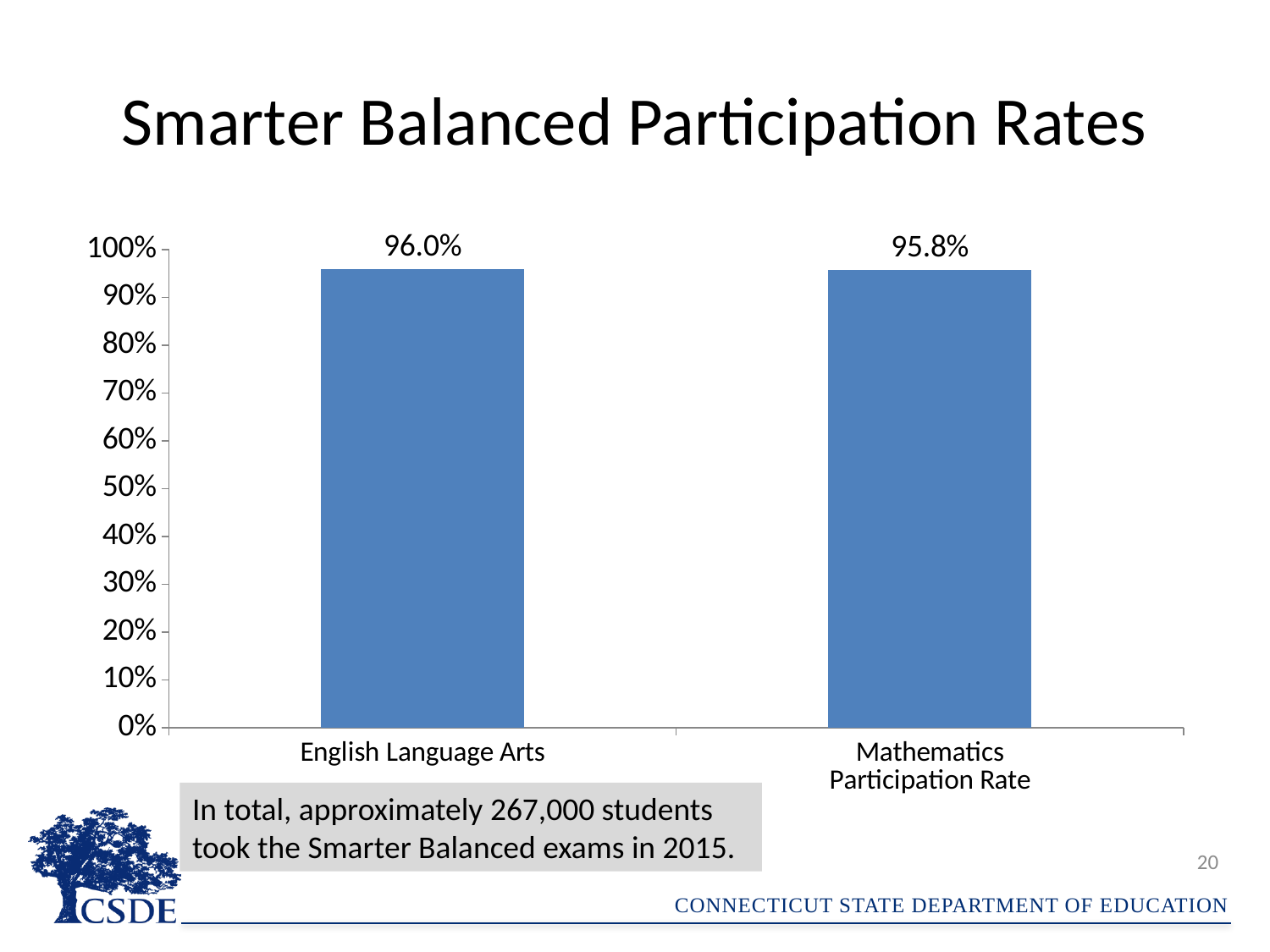
How many categories are shown on the x axis of the chart? 2 What kind of chart is shown on the slide? Bar chart Which category has the higher participation rate according to the data labels? English Language Arts What is the difference between the English Language Arts and Mathematics participation rates? 0.2% What is the value shown for Mathematics Participation Rate? 95.8% Is the English Language Arts participation rate greater or less than 90%? greater What is the participation rate for English Language Arts? 96.0% What is the title of the slide containing the chart? Smarter Balanced Participation Rates What is the highest tick value shown on the y axis? 100% Which category has the lower participation rate according to the data labels? Mathematics Participation Rate Is the Mathematics participation rate greater or less than 100%? less